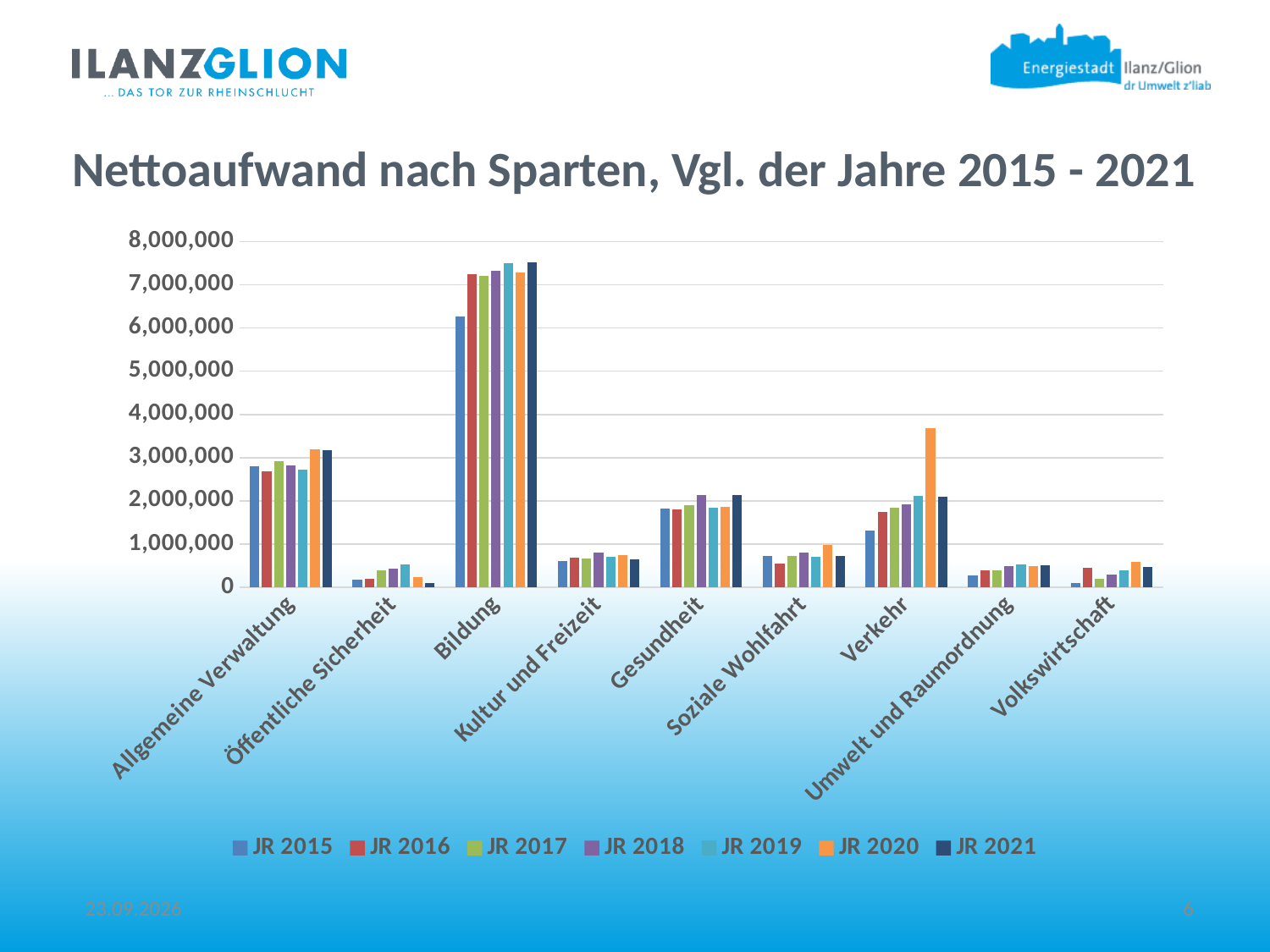
Within the Verkehr category, which year has the highest value? JR 2020 Which is larger for Verkehr: the value for JR 2020 or JR 2021? JR 2020 What kind of chart is shown on the slide? bar chart Is the value for Verkehr in JR 2020 greater or less than 3,000,000? greater Is the value for Kultur und Freizeit in JR 2018 greater or less than 1,000,000? less Which is larger for Bildung: the value for JR 2015 or JR 2016? JR 2016 Is the value for Bildung in JR 2015 greater or less than 6,000,000? greater Which category has the highest values overall? Bildung Within the Bildung category, which year has the lowest value? JR 2015 How many categories are shown on the x axis? 9 How many series does the legend list? 7 What is the title of the chart? Nettoaufwand nach Sparten, Vgl. der Jahre 2015 - 2021